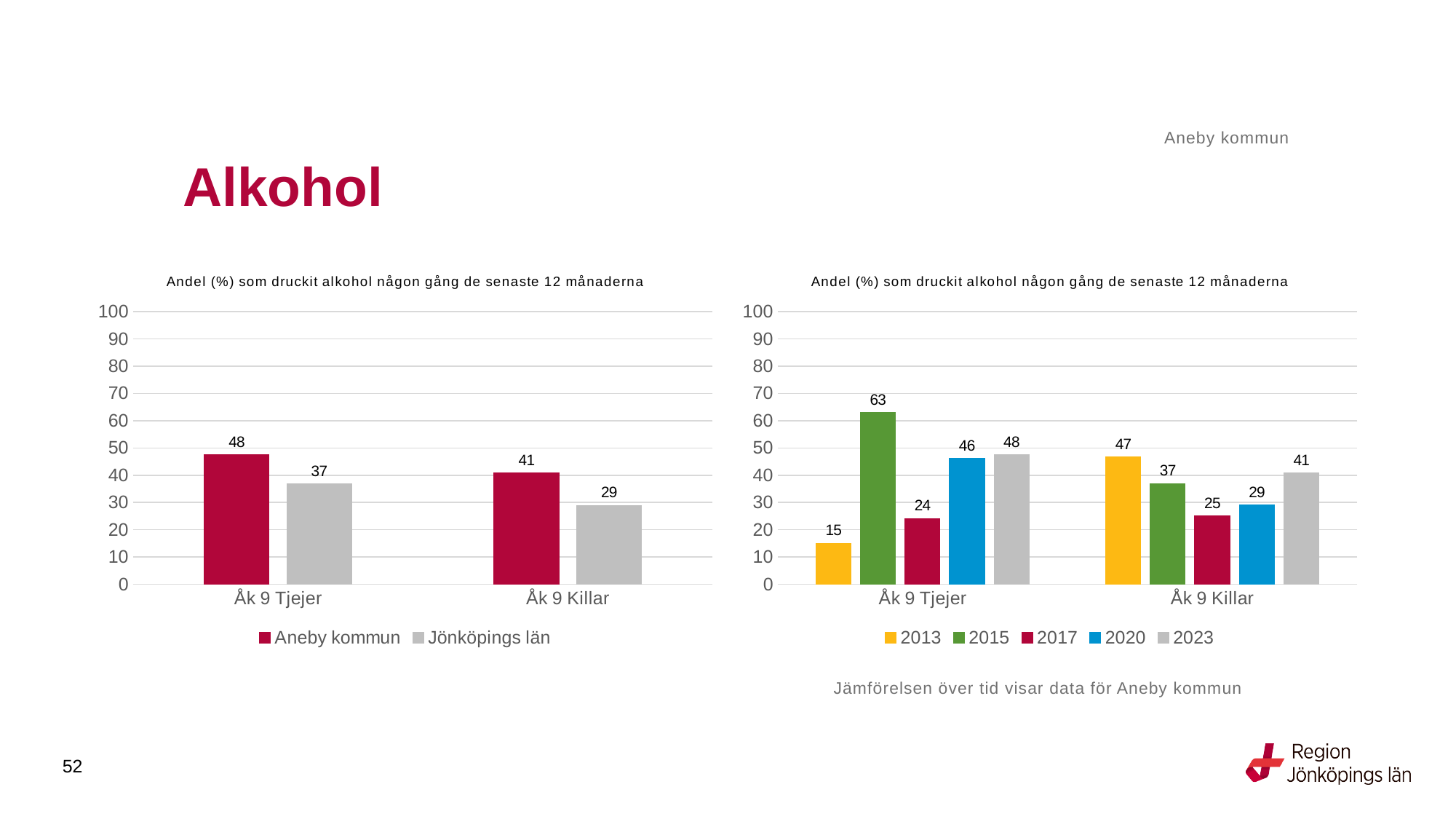
On the right chart, which year has the lowest value for Åk 9 Tjejer? 2013 On the left chart, what is the value for Jönköpings län for Åk 9 Killar? 29 On the right chart, what is the difference between the 2015 and 2017 values for Åk 9 Tjejer? 39 On the right chart, what is the value for 2015 for Åk 9 Tjejer? 63 On the left chart, how many series does the legend list? 2 On the right chart, what is the value for 2013 for Åk 9 Killar? 47 On the right chart, how many series does the legend list? 5 On the left chart, what is the value for Aneby kommun for Åk 9 Tjejer? 48 On the right chart, which year has the highest value for Åk 9 Killar? 2013 What type of chart is the right chart? Bar chart On the left chart, what is the difference between Aneby kommun and Jönköpings län for Åk 9 Killar? 12 On the left chart, which is larger for Åk 9 Tjejer: Aneby kommun or Jönköpings län? Aneby kommun